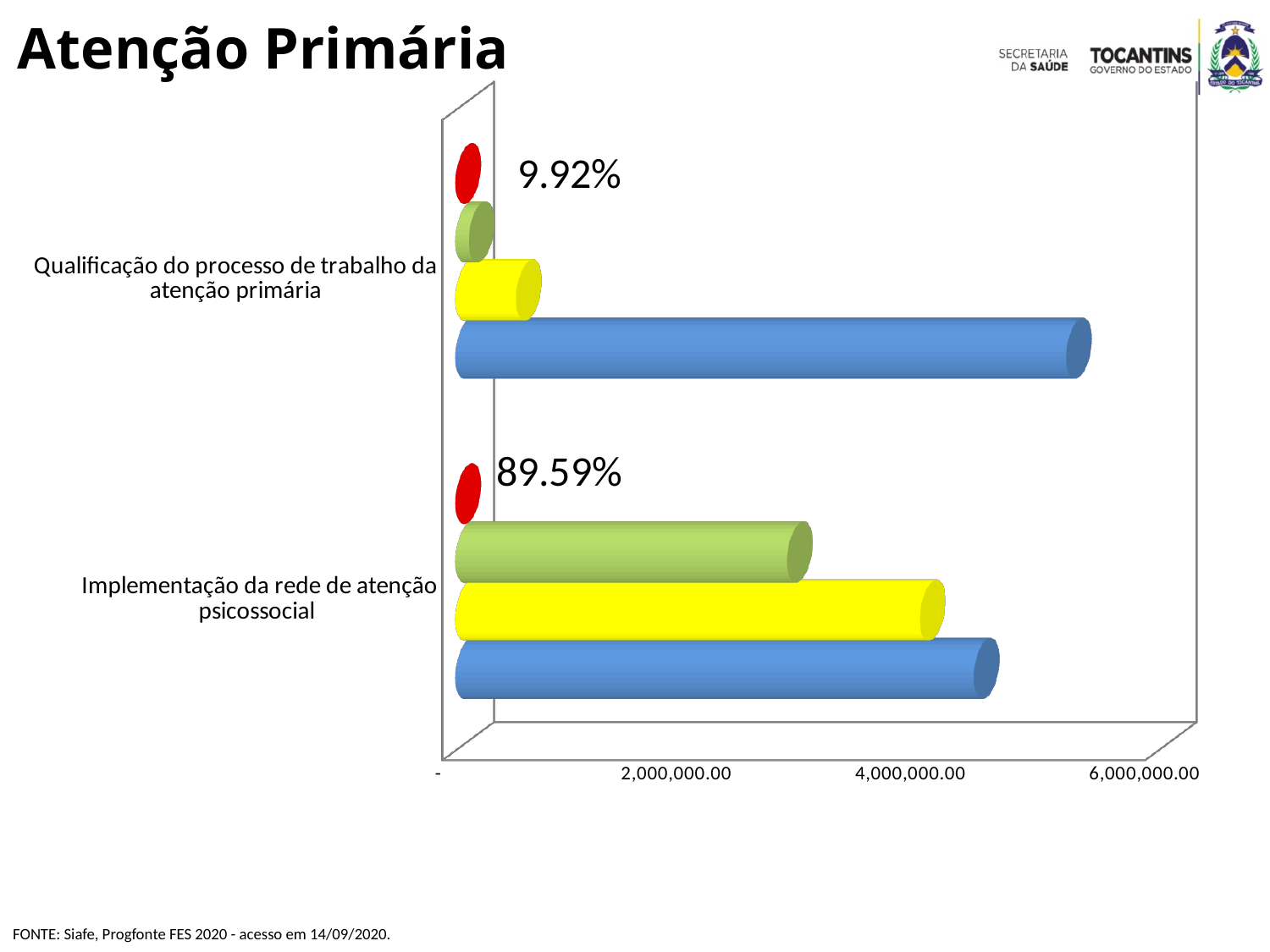
What percentage label is shown for "Qualificação do processo de trabalho da atenção primária"? 9.92% What is the title of the slide containing the chart? Atenção Primária Which category has the higher percentage label, "Qualificação do processo de trabalho da atenção primária" or "Implementação da rede de atenção psicossocial"? Implementação da rede de atenção psicossocial Which category has the longer green bar? Implementação da rede de atenção psicossocial Is the value of the yellow bar for "Qualificação do processo de trabalho da atenção primária" greater or less than 2,000,000.00? less How many categories are shown on the vertical axis of the chart? 2 What percentage label is shown for "Implementação da rede de atenção psicossocial"? 89.59% Is the value of the green bar for "Implementação da rede de atenção psicossocial" greater or less than 4,000,000.00? less What kind of chart is shown on the slide? bar chart Is the value of the blue bar for "Qualificação do processo de trabalho da atenção primária" greater or less than 4,000,000.00? greater Which category has the longer blue bar? Qualificação do processo de trabalho da atenção primária What is the difference between the two percentage labels shown on the chart (89.59% and 9.92%)? 79.67%